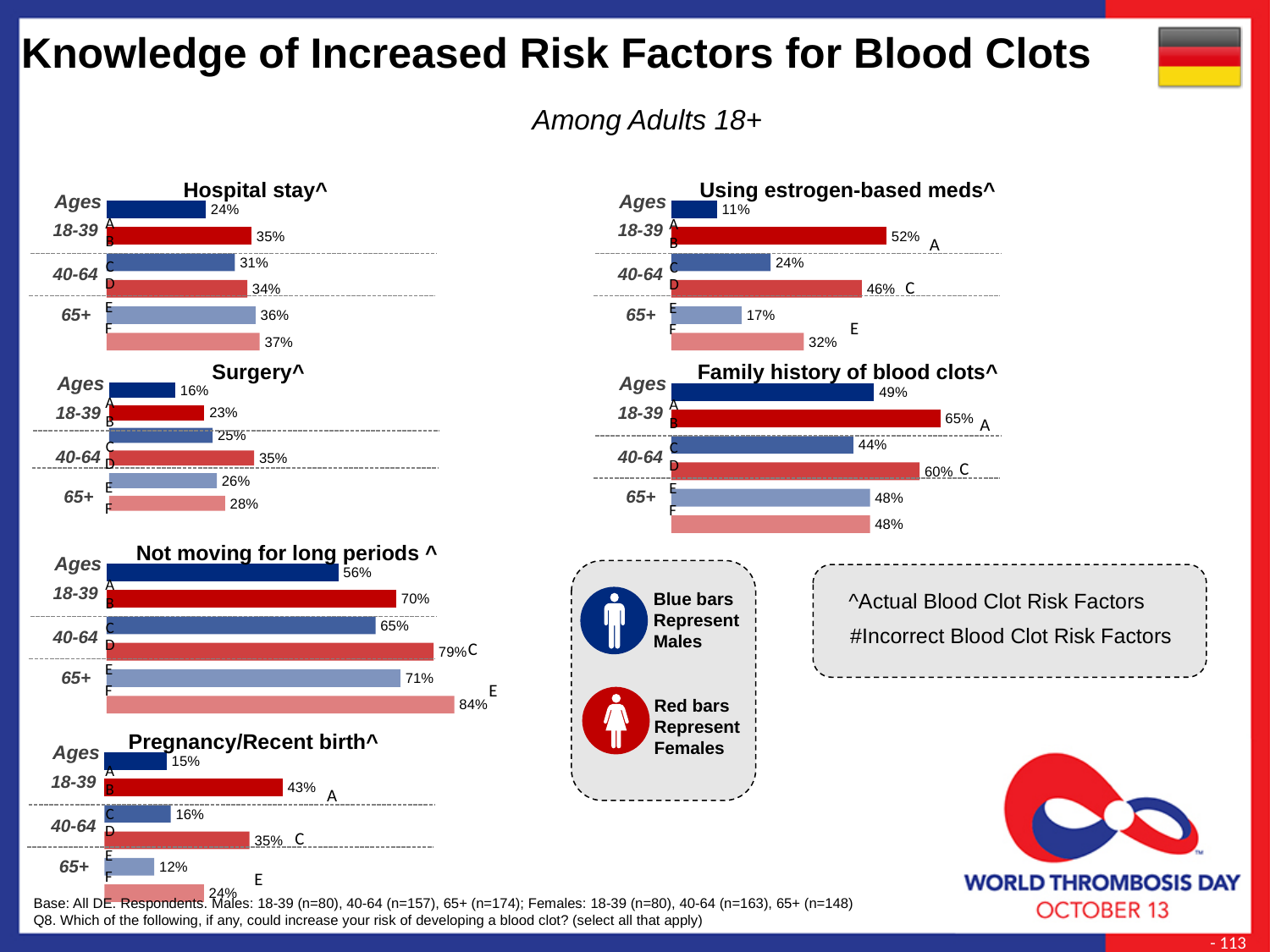
In the 'Pregnancy/Recent birth' chart, what is the difference between females and males aged 40-64? 19 percentage points In the 'Surgery' chart, what is the value for males aged 40-64? 25% In the 'Family history of blood clots' chart, what is the value for males aged 65+? 48% In the 'Using estrogen-based meds' chart, what is the difference between females and males aged 18-39? 41 percentage points In the 'Not moving for long periods' chart, do the male values rise or fall from the 18-39 group to the 65+ group? Rise According to the legend on the slide, what do the red bars represent? Females In the 'Family history of blood clots' chart, which is larger: females aged 40-64 or males aged 40-64? Females aged 40-64 (60%) In the 'Pregnancy/Recent birth' chart, which bar has the lowest value? Males 65+ (12%) In the 'Hospital stay' chart, what is the value for females aged 18-39? 35% What type of chart is used for 'Hospital stay'? Bar chart How many age groups are shown in each chart on the slide? 3 In the 'Not moving for long periods' chart, which age group and gender has the highest value? Females 65+ (84%)